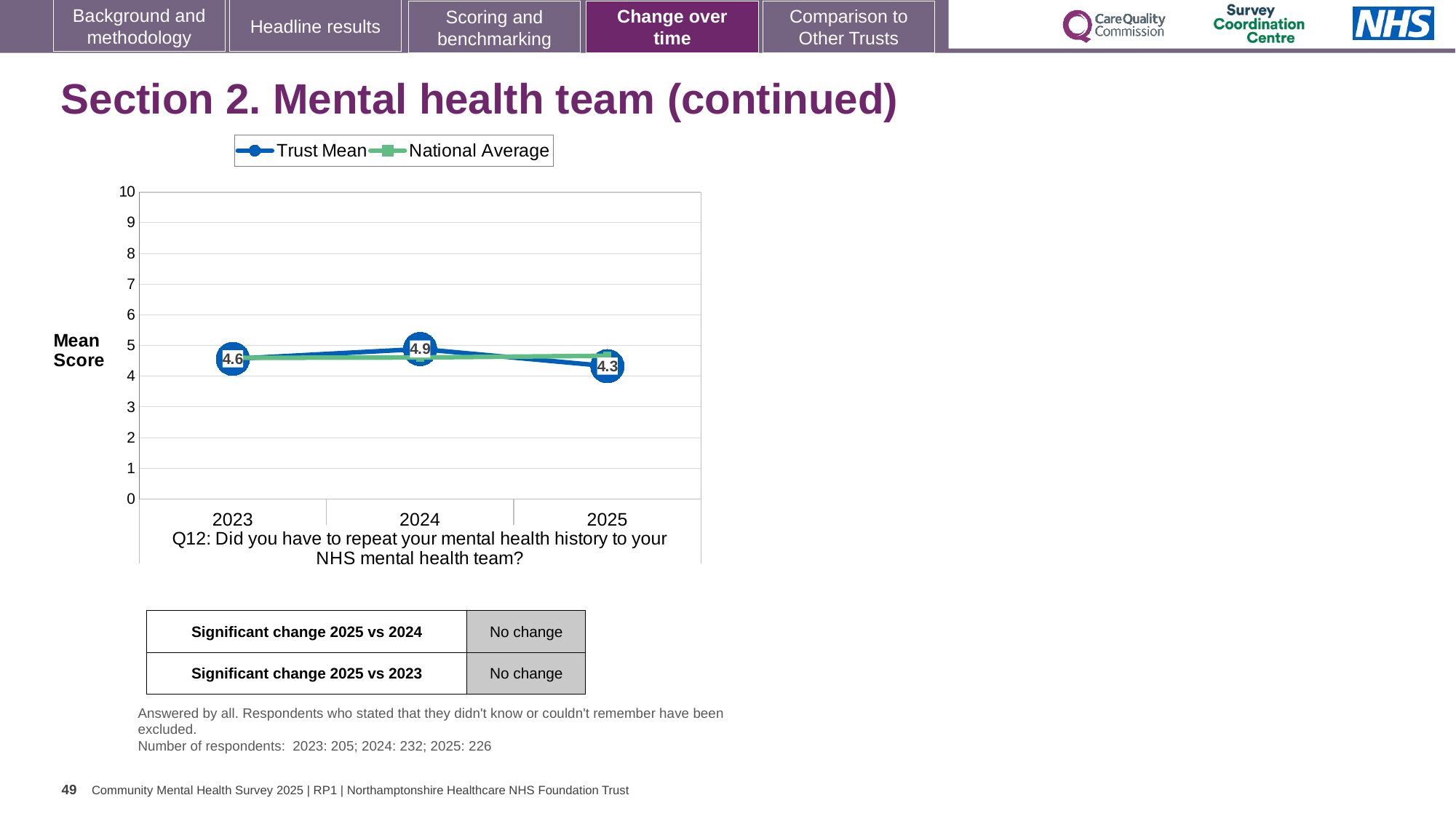
Is the National Average value for 2024 greater or less than 5? less What is the Trust Mean score for 2023? 4.6 Does the Trust Mean score rise or fall from 2024 to 2025? Fall What is the Trust Mean score for 2025? 4.3 What kind of chart is shown on the slide? Line chart What is the Trust Mean score for 2024? 4.9 How many series does the legend list? 2 In which year is the Trust Mean score highest? 2024 Which year has the larger Trust Mean score, 2023 or 2025? 2023 What is the difference between the Trust Mean scores for 2024 and 2025? 0.6 In which year is the Trust Mean score lowest? 2025 How many years are plotted on the x axis? 3